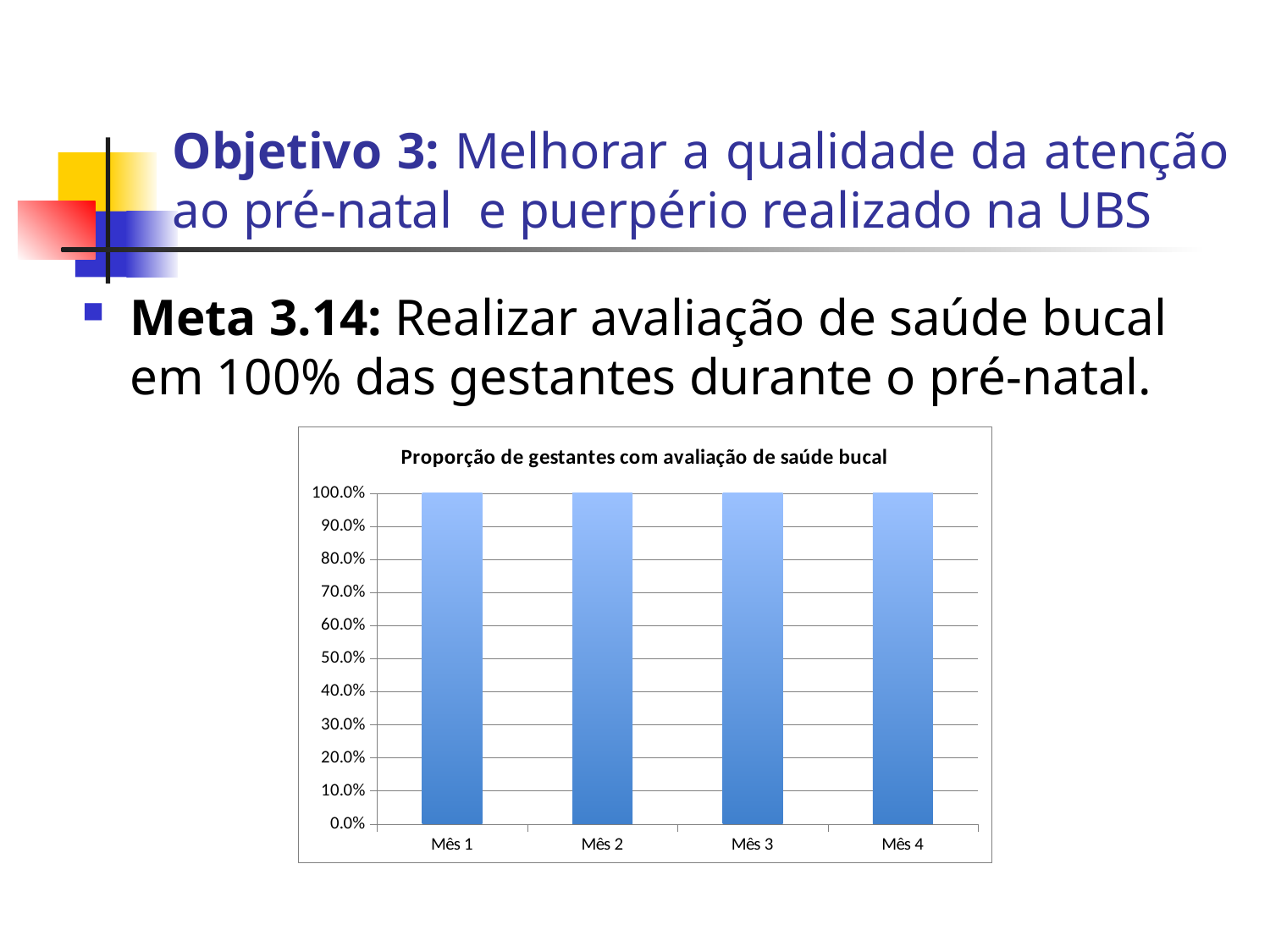
Do the values rise, fall or stay the same from Mês 1 to Mês 4? stay the same What is the value for Mês 1? 100.0% What kind of chart is shown on the slide? bar chart What is the value for Mês 4? 100.0% Is the value for Mês 4 greater or less than 90.0%? greater What is the title of the chart? Proporção de gestantes com avaliação de saúde bucal What colour are the bars in the chart? blue What is the difference between the values for Mês 1 and Mês 2? 0.0% Is the value for Mês 2 greater or less than 50.0%? greater How many categories are shown on the x axis? 4 What is the highest value shown on the y axis? 100.0% What is the value for Mês 3? 100.0%